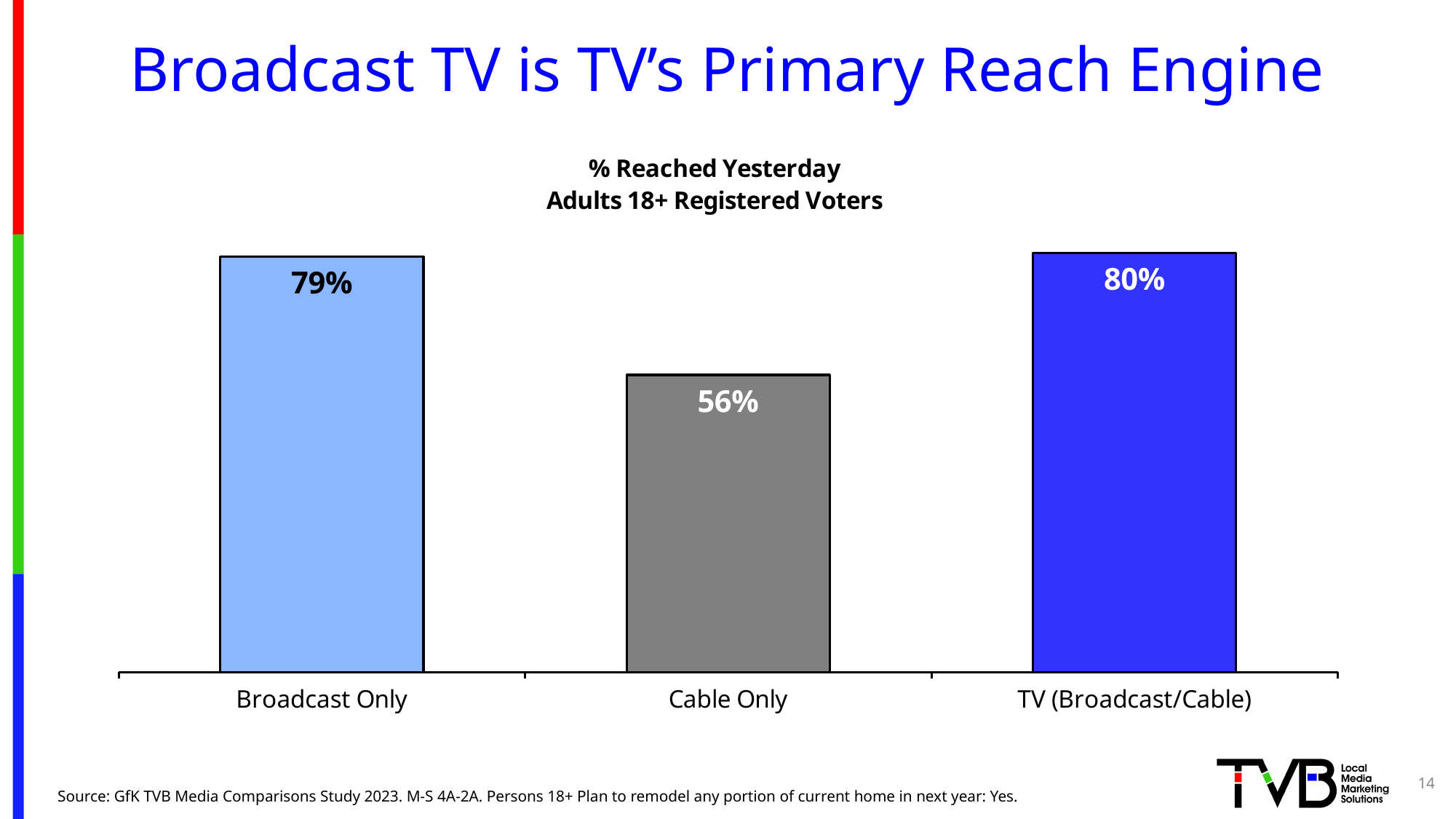
How many categories are shown in the chart? 3 Which is larger, the value for Broadcast Only or the value for Cable Only? Broadcast Only What kind of chart is shown on the slide? Bar chart What is the value for TV (Broadcast/Cable)? 80% What is the value for Cable Only? 56% What is the value for Broadcast Only? 79% Which category has the highest value according to the data labels? TV (Broadcast/Cable) Which category has the lowest value? Cable Only What is the difference between the values for Broadcast Only and Cable Only? 23 percentage points What is the title of the chart? % Reached Yesterday Adults 18+ Registered Voters What is the difference between the values for TV (Broadcast/Cable) and Cable Only? 24 percentage points What colour is the bar for Cable Only? Gray